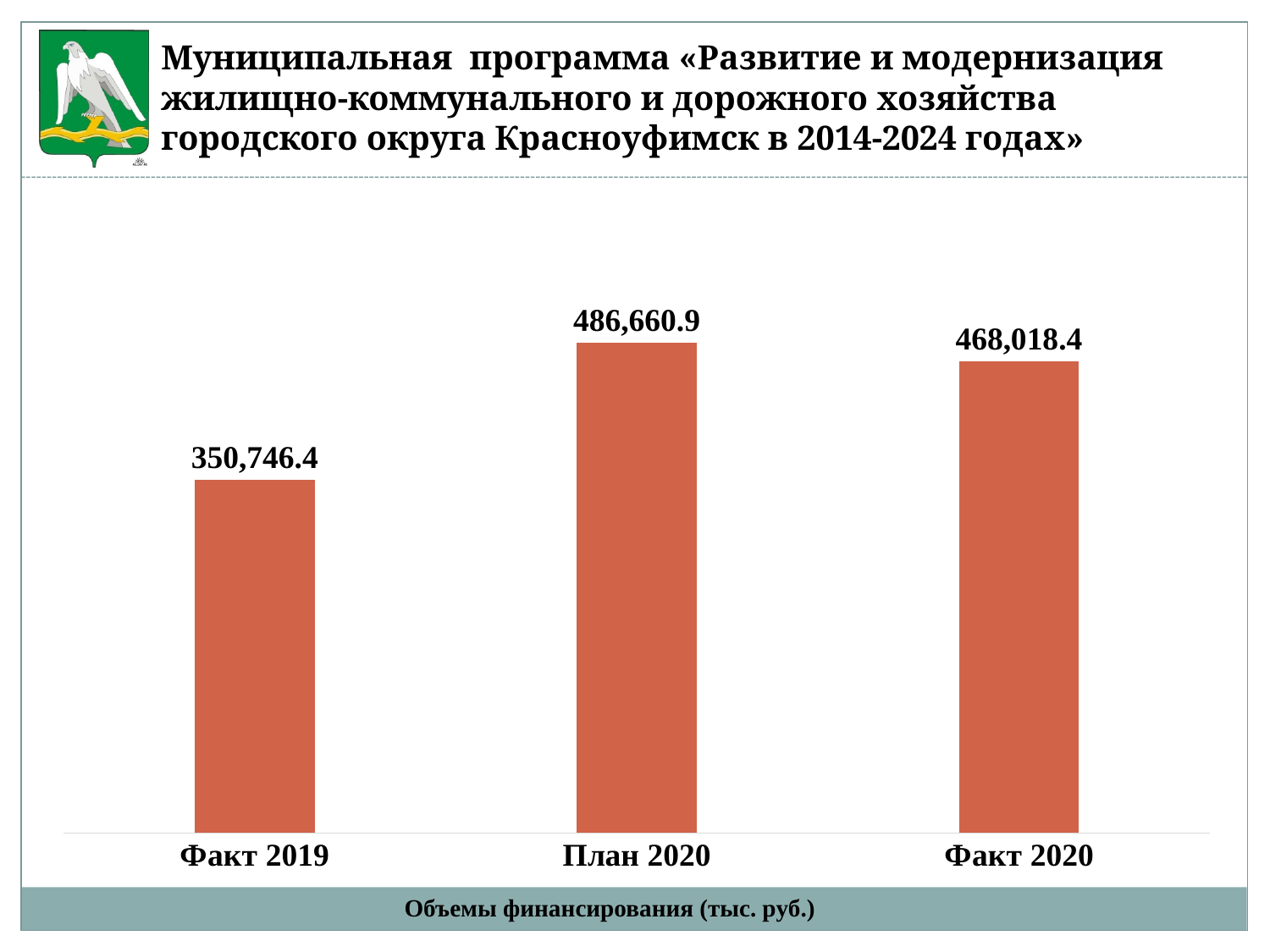
What is the difference between План 2020 and Факт 2020? 18,642.5 What is the difference between Факт 2020 and Факт 2019? 117,272.0 What unit of measurement is given in the caption below the chart? тыс. руб. What is the value for Факт 2020? 468,018.4 Which category has the highest value? План 2020 How many categories are shown in the chart? 3 Which is larger, the value for Факт 2019 or the value for Факт 2020? Факт 2020 What is the value for План 2020? 486,660.9 What is the value for Факт 2019? 350,746.4 What kind of chart is shown on the slide? Bar chart What is the difference between План 2020 and Факт 2019? 135,914.5 Which category has the lowest value? Факт 2019